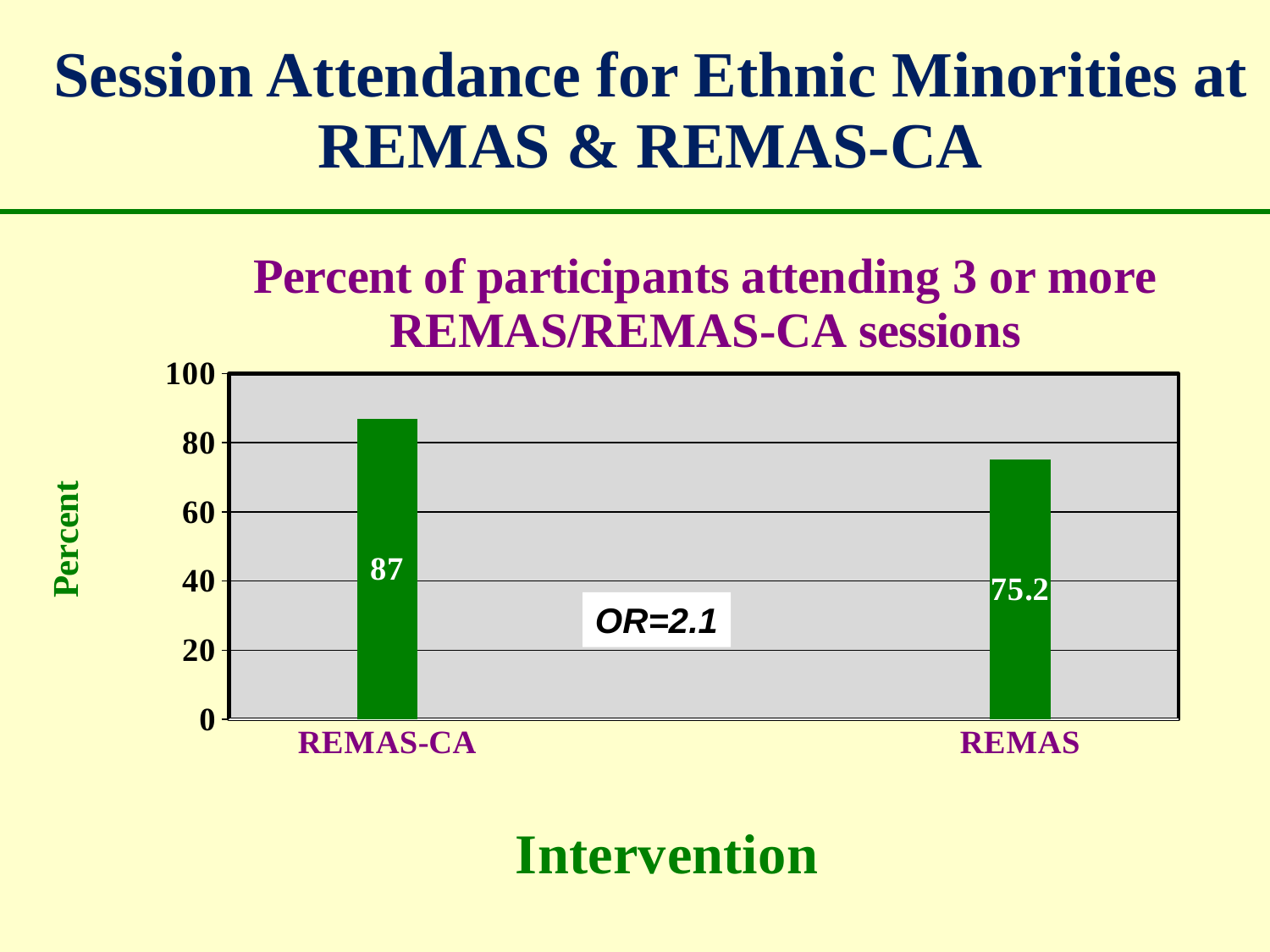
What odds ratio is printed inside the chart area? OR=2.1 What is the value for REMAS? 75.2 What is the difference between the values for REMAS-CA and REMAS? 11.8 What is the value for REMAS-CA? 87 Is the value for REMAS-CA greater or less than 80? greater Which intervention has the lower percentage of participants attending 3 or more sessions? REMAS What kind of chart is shown on the slide? bar chart Which intervention has the higher percentage of participants attending 3 or more sessions? REMAS-CA Is the value for REMAS-CA larger or smaller than the value for REMAS? larger What is the label of the y axis? Percent Is the value for REMAS greater or less than 80? less How many interventions are shown on the x axis? 2